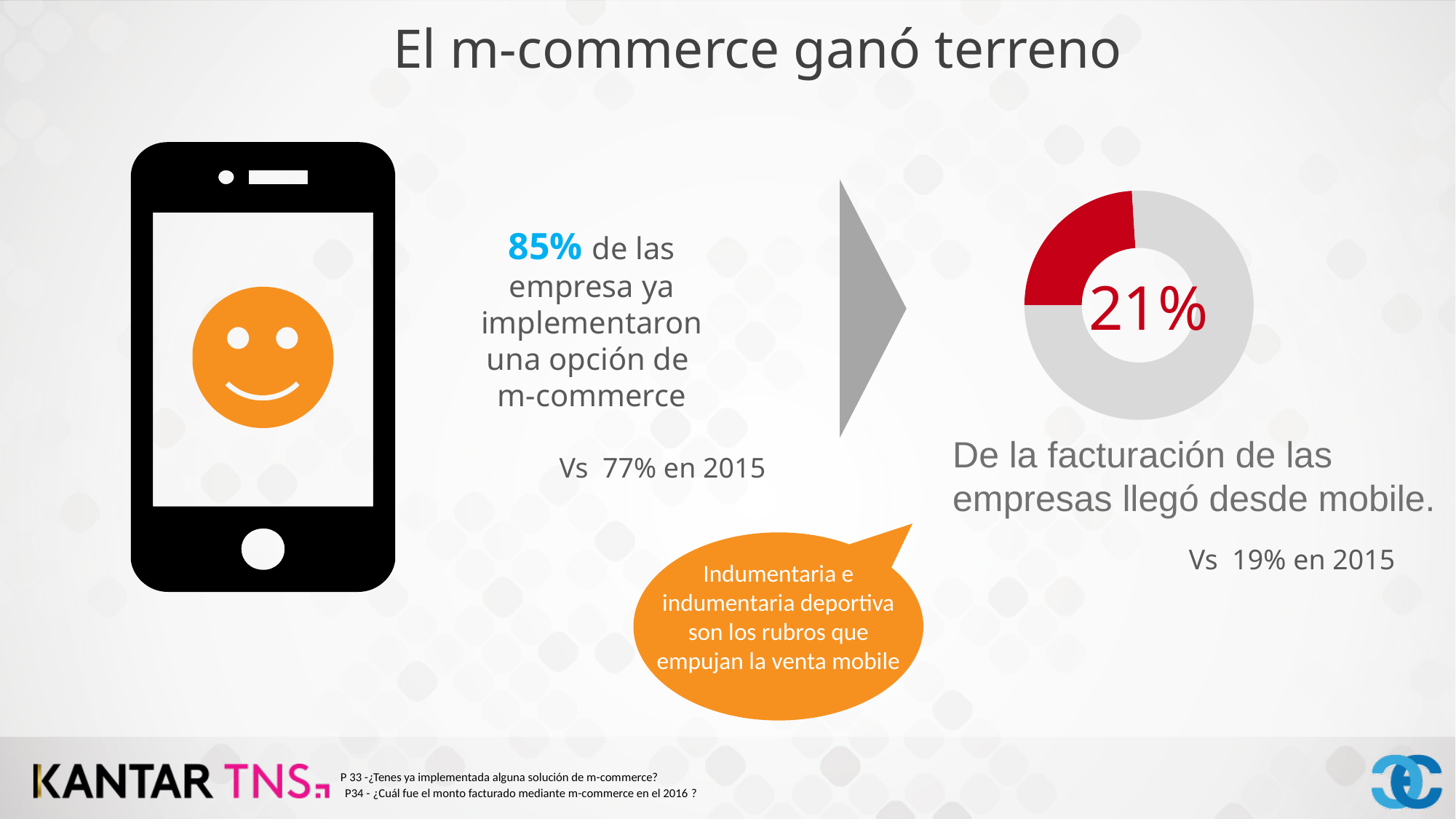
How many slices does the donut chart have? 2 What kind of chart is shown on the right side of the slide? Donut chart In the donut chart, which slice is larger, the red one or the grey one? The grey one What was the share of revenue from mobile in 2015, as stated next to the donut chart? 19% What colour is the slice representing the 21% share in the donut chart? Red Is the value of the red slice in the donut chart greater or less than 50%? less What percentage is printed in the centre of the donut chart? 21% Did the share of revenue from mobile rise or fall from 2015 to the value shown in the donut chart? Rise What is the title of the slide containing the donut chart? El m-commerce ganó terreno According to the donut chart, what share of companies' revenue came from mobile? 21% By how many percentage points did the share of revenue from mobile shown in the donut chart rise compared with the 19% in 2015? 2 percentage points